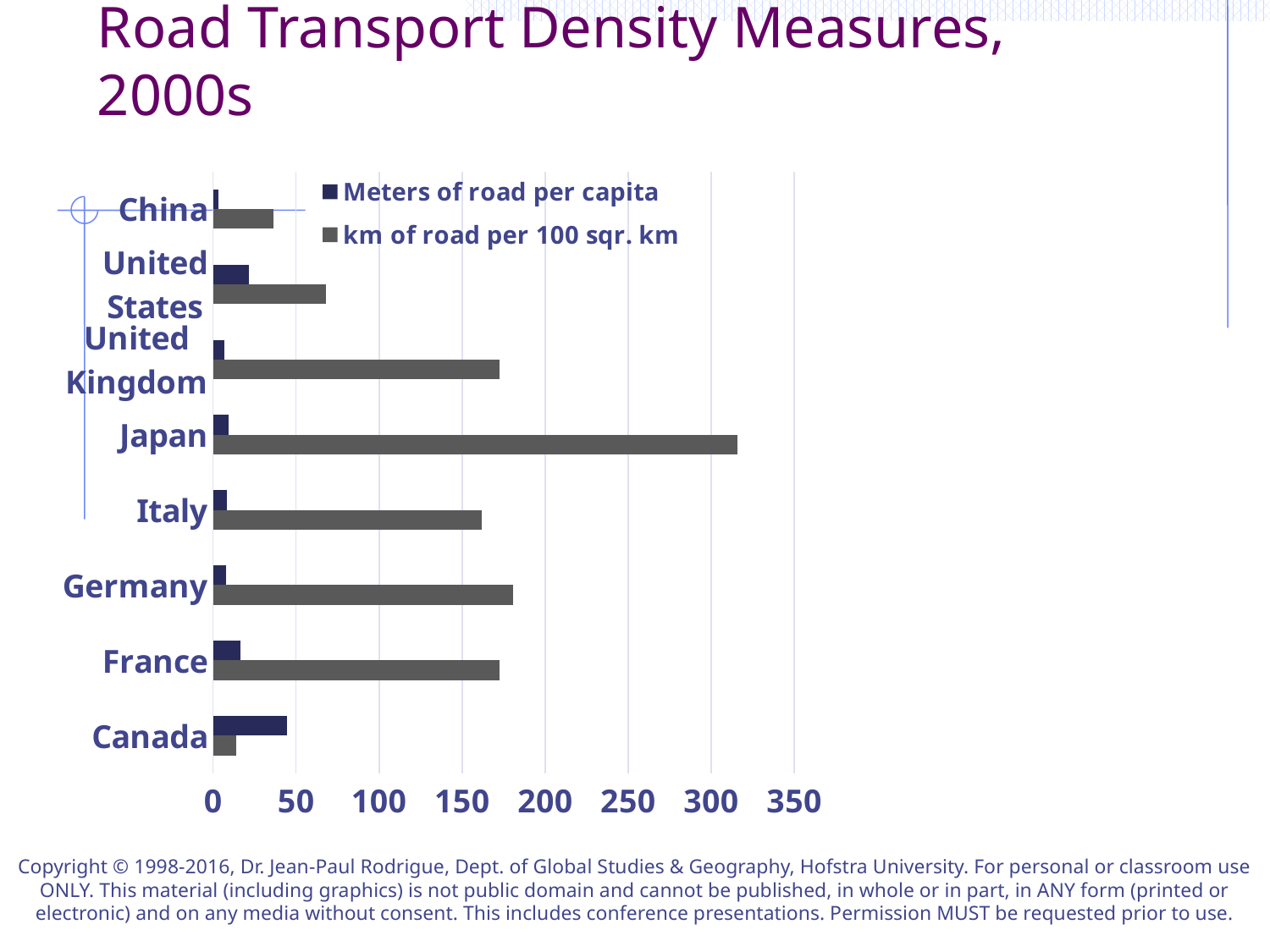
Is the value of km of road per 100 sqr. km for Japan greater or less than 300? greater What is the title of the slide containing the chart? Road Transport Density Measures, 2000s Is the value of km of road per 100 sqr. km for the United States greater or less than 100? less Which country has the highest value for km of road per 100 sqr. km? Japan Which is larger: km of road per 100 sqr. km for Germany or for Italy? Germany Which country has the highest value for meters of road per capita? Canada How many countries are shown on the chart? 8 Is the value of km of road per 100 sqr. km for Germany greater or less than 150? greater What kind of chart is shown on the slide? bar chart Which country has the lowest value for km of road per 100 sqr. km? Canada How many series does the legend list? 2 Which is larger: meters of road per capita for Canada or for China? Canada